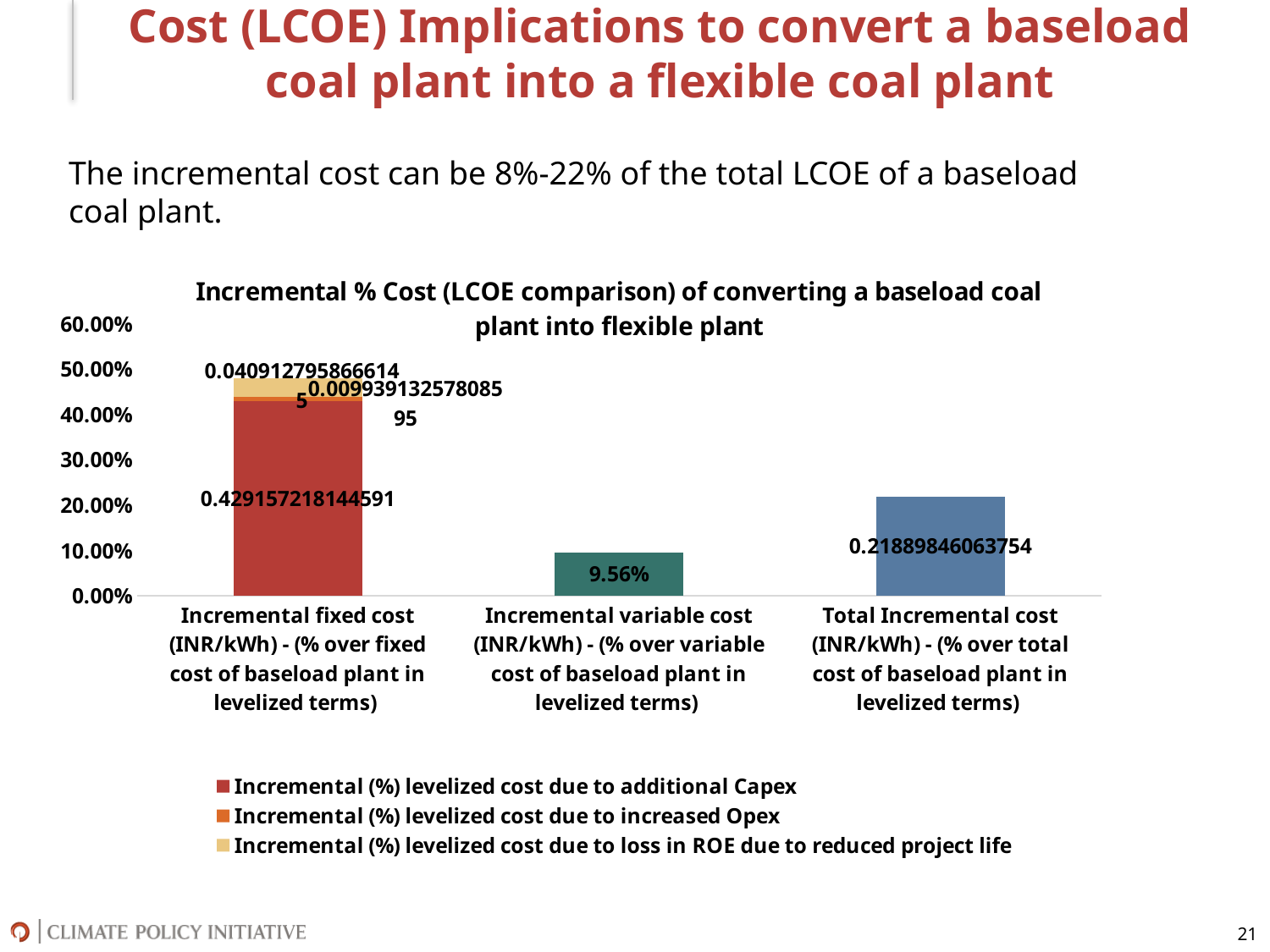
What is the title of the chart? Incremental % Cost (LCOE comparison) of converting a baseload coal plant into flexible plant How many series does the legend list? 3 How many categories are shown on the x axis? 3 Is the Incremental variable cost bar greater or less than 10.00%? less What type of chart is shown on the slide? Bar chart What is the data label for the Capex portion (red) of the Incremental fixed cost bar? 0.429157218144591 Which category has the tallest bar? Incremental fixed cost (INR/kWh) - (% over fixed cost of baseload plant in levelized terms) Is the Total Incremental cost bar greater or less than 20.00%? greater Which category has the shortest bar? Incremental variable cost (INR/kWh) - (% over variable cost of baseload plant in levelized terms) What is the data label shown for the Total Incremental cost bar? 0.21889846063754 What is the data label shown for the Incremental variable cost bar? 9.56% What is the data label for the loss in ROE portion (yellow) of the Incremental fixed cost bar? 0.040912795866614